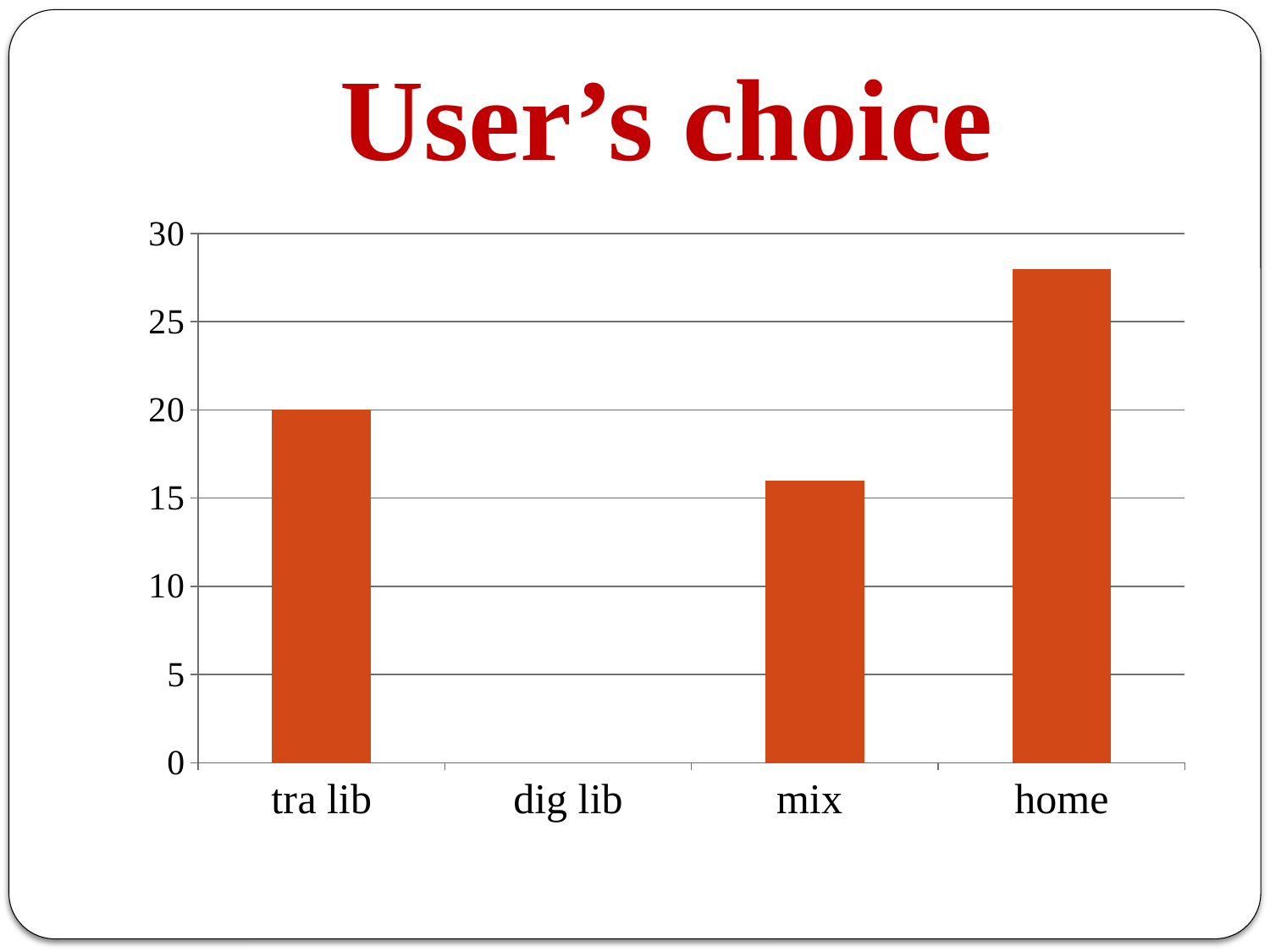
Which category has the highest value? home What kind of chart is shown on the slide? bar chart How many categories are shown on the x axis? 4 Is the value for home greater or less than 25? greater Which category has the lowest value? dig lib Is the value for mix greater or less than 15? greater What is the title of the slide? User's choice Is the value for mix greater or less than 20? less Which is larger, the value for home or the value for tra lib? home Which is larger, the value for tra lib or the value for mix? tra lib What is the value for tra lib? 20